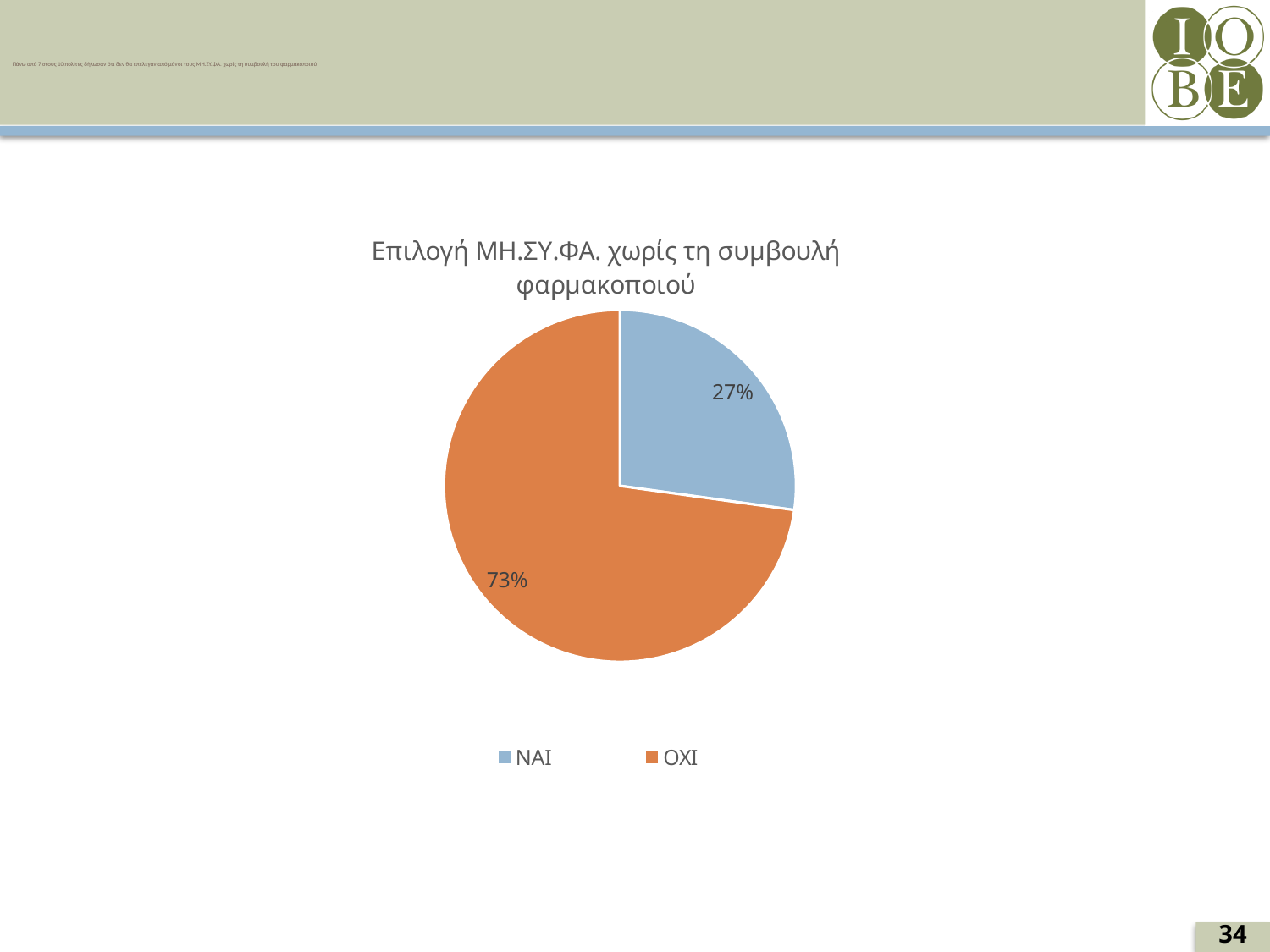
What is the difference between the shares for ΟΧΙ and ΝΑΙ? 46% What is the title of the chart? Επιλογή ΜΗ.ΣΥ.ΦΑ. χωρίς τη συμβουλή φαρμακοποιού Which category has the smallest share of the pie? ΝΑΙ What share of the pie does ΝΑΙ represent? 27% How many categories does the pie chart show? 2 What is the value for ΝΑΙ? 27% What is the value for ΟΧΙ? 73% What colour is the ΟΧΙ slice? orange How many entries does the legend list? 2 What kind of chart is shown on the slide? pie chart Which is larger, the share for ΝΑΙ or the share for ΟΧΙ? ΟΧΙ Which category has the largest share of the pie? ΟΧΙ